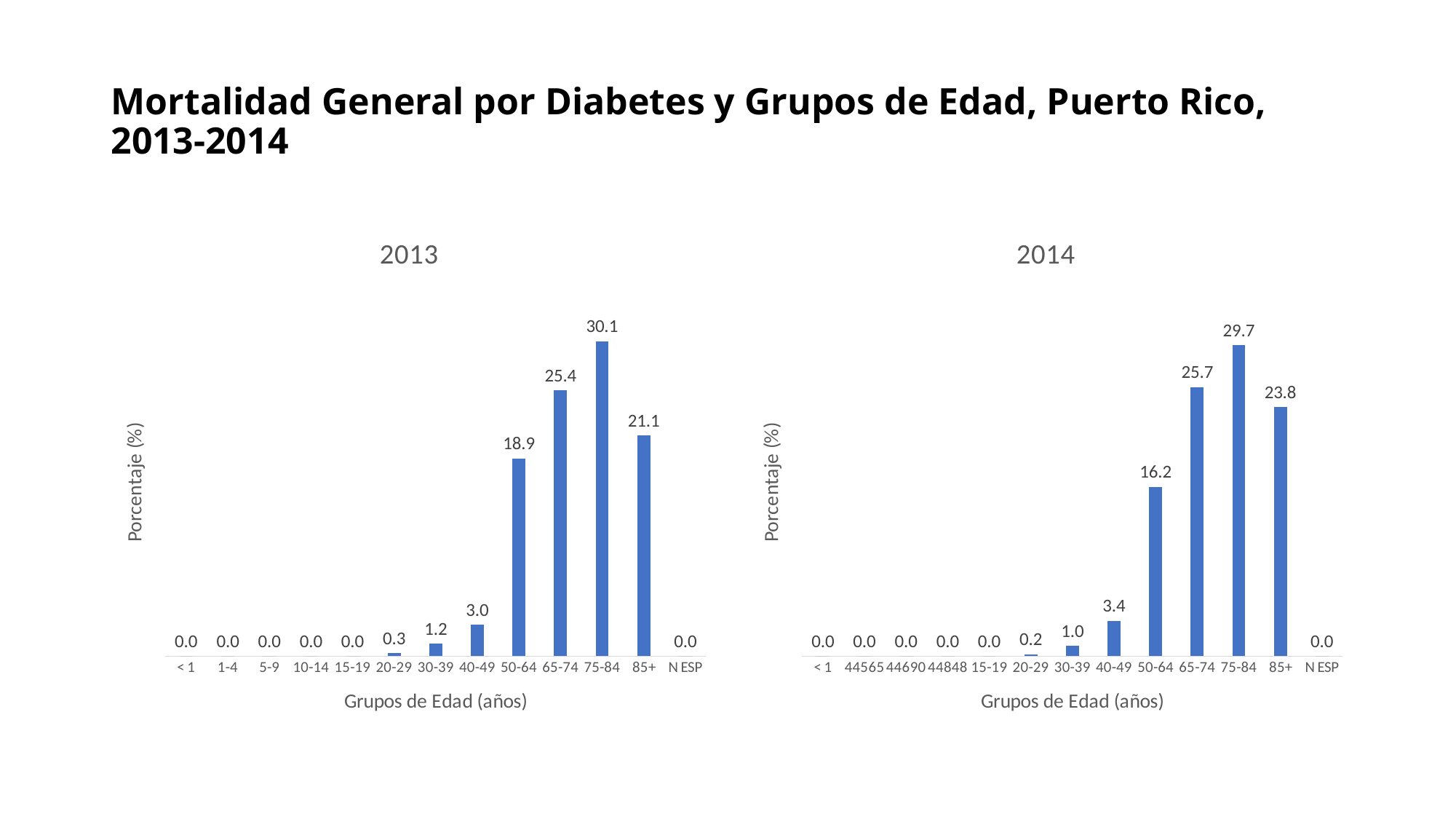
In the 2014 chart, which is larger, the value for 85+ or the value for 65-74? 65-74 In the 2014 chart, what is the value for the 50-64 age group? 16.2 What kind of chart is the 2014 chart? bar chart In the 2013 chart, what is the value for the 20-29 age group? 0.3 In the 2013 chart, which age group has the highest value? 75-84 How many age group categories are shown on the x axis of the 2013 chart? 13 In the 2014 chart, which age group has the highest value? 75-84 What is the y-axis label of the 2013 chart? Porcentaje (%) In the 2013 chart, which is larger, the value for 40-49 or the value for 30-39? 40-49 In the 2013 chart, what is the value for the 75-84 age group? 30.1 In the 2013 chart, what is the difference between the values for 75-84 and 85+? 9.0 In the 2014 chart, what is the difference between the values for 65-74 and 50-64? 9.5